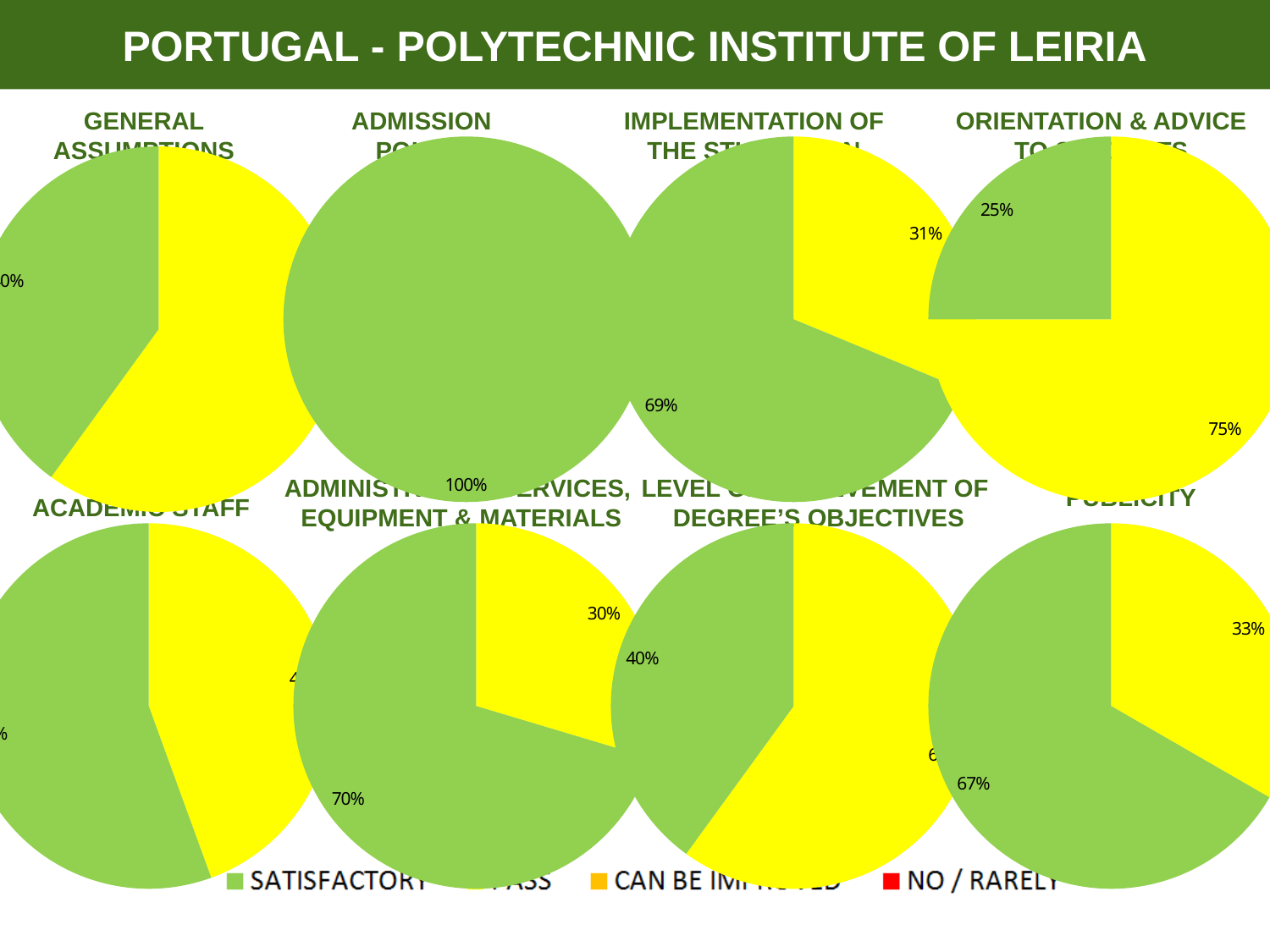
In the Orientation & Advice pie chart (top right), what percentage does the green slice show? 25% In the Publicity pie chart, what percentage does the green slice show? 67% In the Orientation & Advice pie chart (top right), which slice is larger, the green one or the yellow one? yellow In the Implementation pie chart (third in the top row), what is the difference in percentage points between the green slice and the yellow slice? 38 percentage points In the Orientation & Advice pie chart (top right), what percentage does the yellow slice show? 75% What kind of charts are shown on the slide? pie charts In the Implementation pie chart (third in the top row), what percentage does the yellow slice show? 31% In the Administrative Services, Equipment & Materials pie chart, what percentage does the yellow slice show? 30% In the Admission pie chart (second in the top row), what percentage is labelled on the chart? 100% In the Publicity pie chart, what percentage does the yellow slice show? 33% In the Administrative Services, Equipment & Materials pie chart, what percentage does the green slice show? 70% In the Implementation pie chart (third in the top row), what percentage does the green slice show? 69%